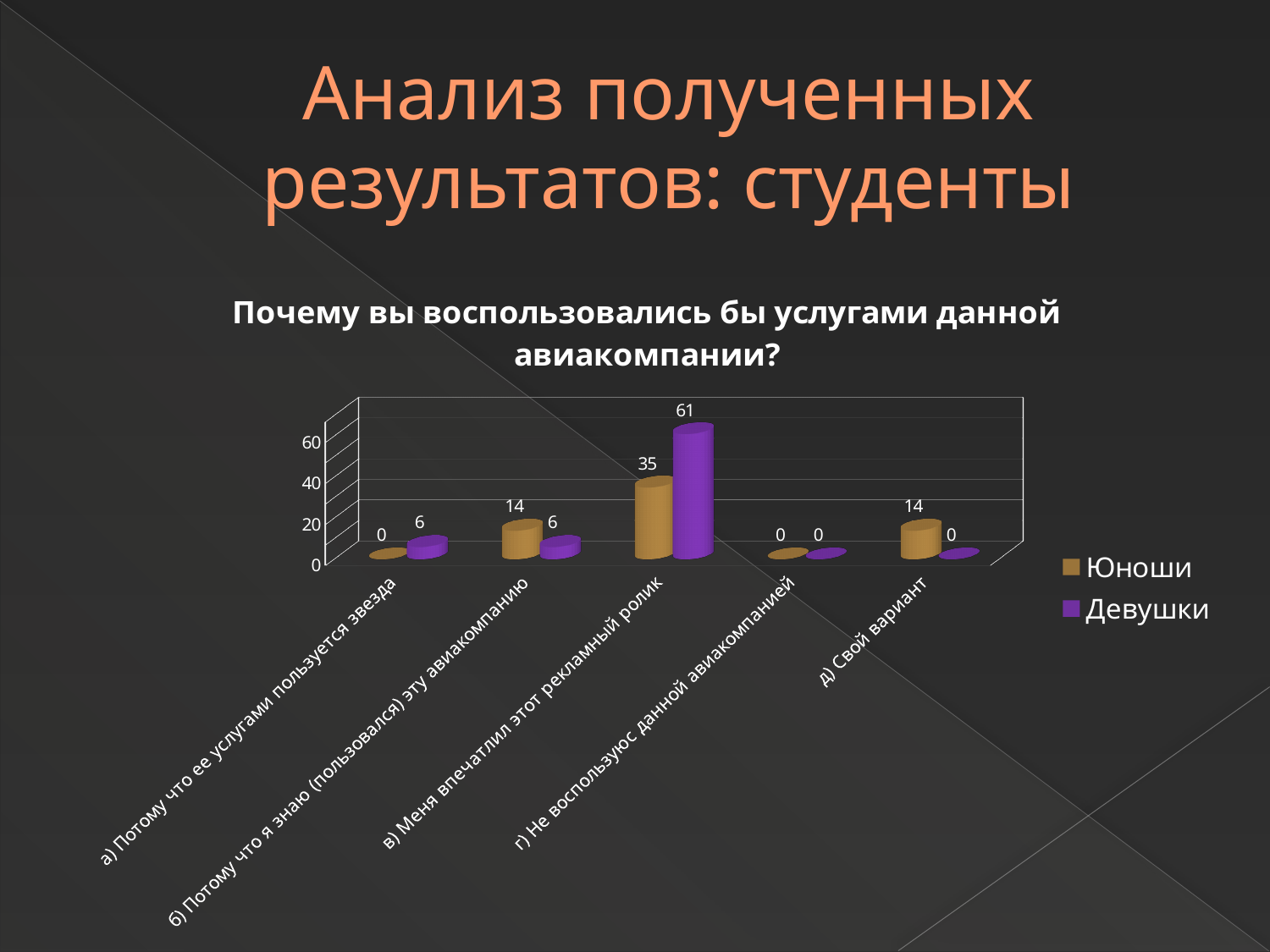
What is the value for Девушки in category а) Потому что ее услугами пользуется звезда? 6 What is the difference between the Девушки and Юноши values in category в) Меня впечатлил этот рекламный ролик? 26 How many series does the legend list? 2 Which colour represents the Девушки series? purple What is the value for Юноши in category в) Меня впечатлил этот рекламный ролик? 35 In category б) Потому что я знаю (пользовался) эту авиакомпанию, which series has the larger value, Юноши or Девушки? Юноши Which category has the highest value for Девушки? в) Меня впечатлил этот рекламный ролик What is the chart's title? Почему вы воспользовались бы услугами данной авиакомпании? How many categories are shown on the x axis? 5 What is the value for Девушки in category в) Меня впечатлил этот рекламный ролик? 61 What is the value for Юноши in category д) Свой вариант? 14 What type of chart is shown on the slide? bar chart